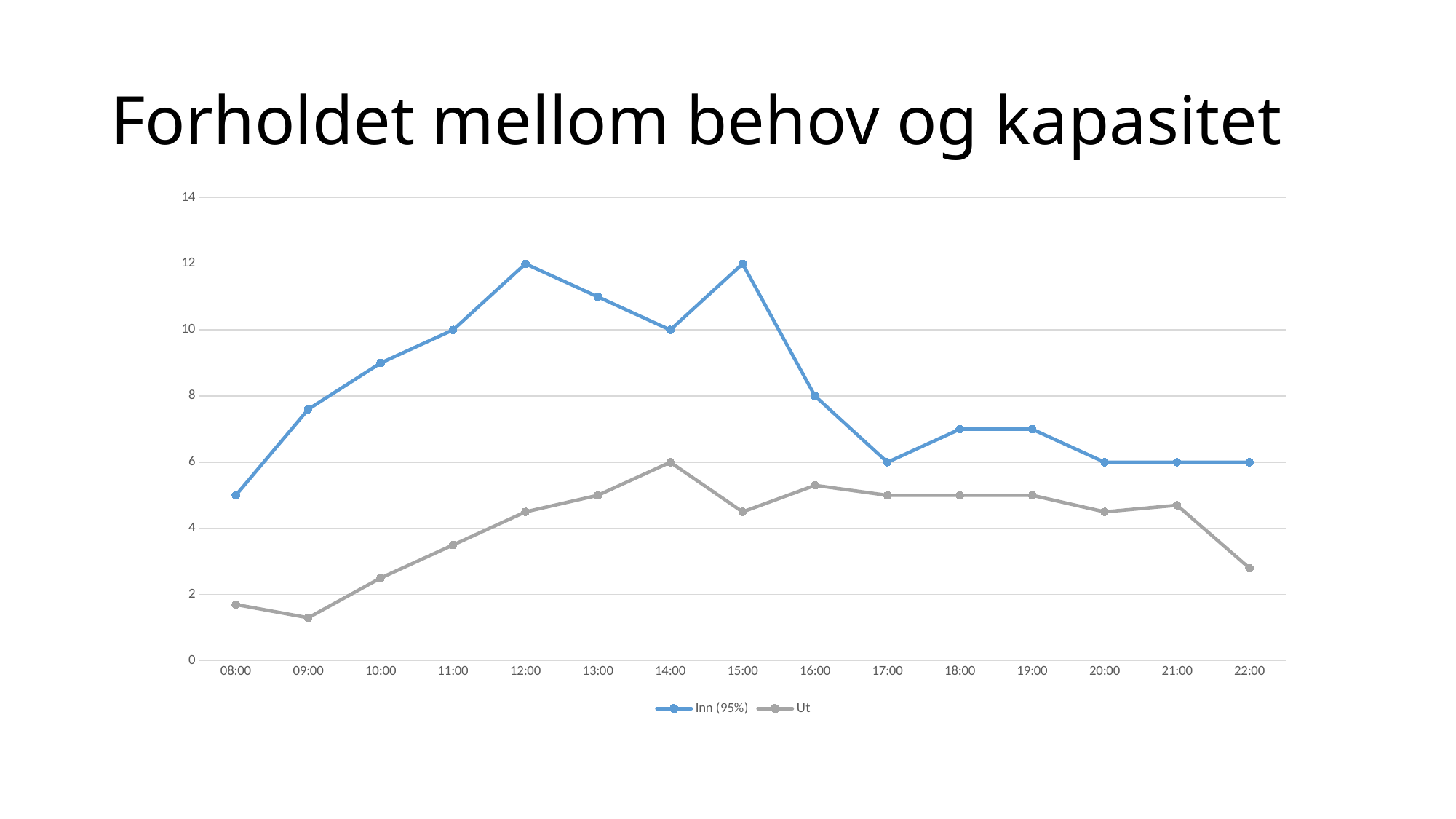
What is the title of the chart? Forholdet mellom behov og kapasitet At which time is the Ut series lowest? 09:00 How many series does the legend list? 2 What is the value of Inn (95%) at 16:00? 8 How many time points are plotted along the x axis? 15 Does the Inn (95%) series rise or fall from 08:00 to 12:00? rise What kind of chart is shown on the slide? line chart What is the value of Inn (95%) at 12:00? 12 Is the value for Inn (95%) at 09:00 greater or less than 6? greater What is the value of Ut at 14:00? 6 At which time is the Ut series highest? 14:00 What is the difference between Inn (95%) at 12:00 and Inn (95%) at 16:00? 4